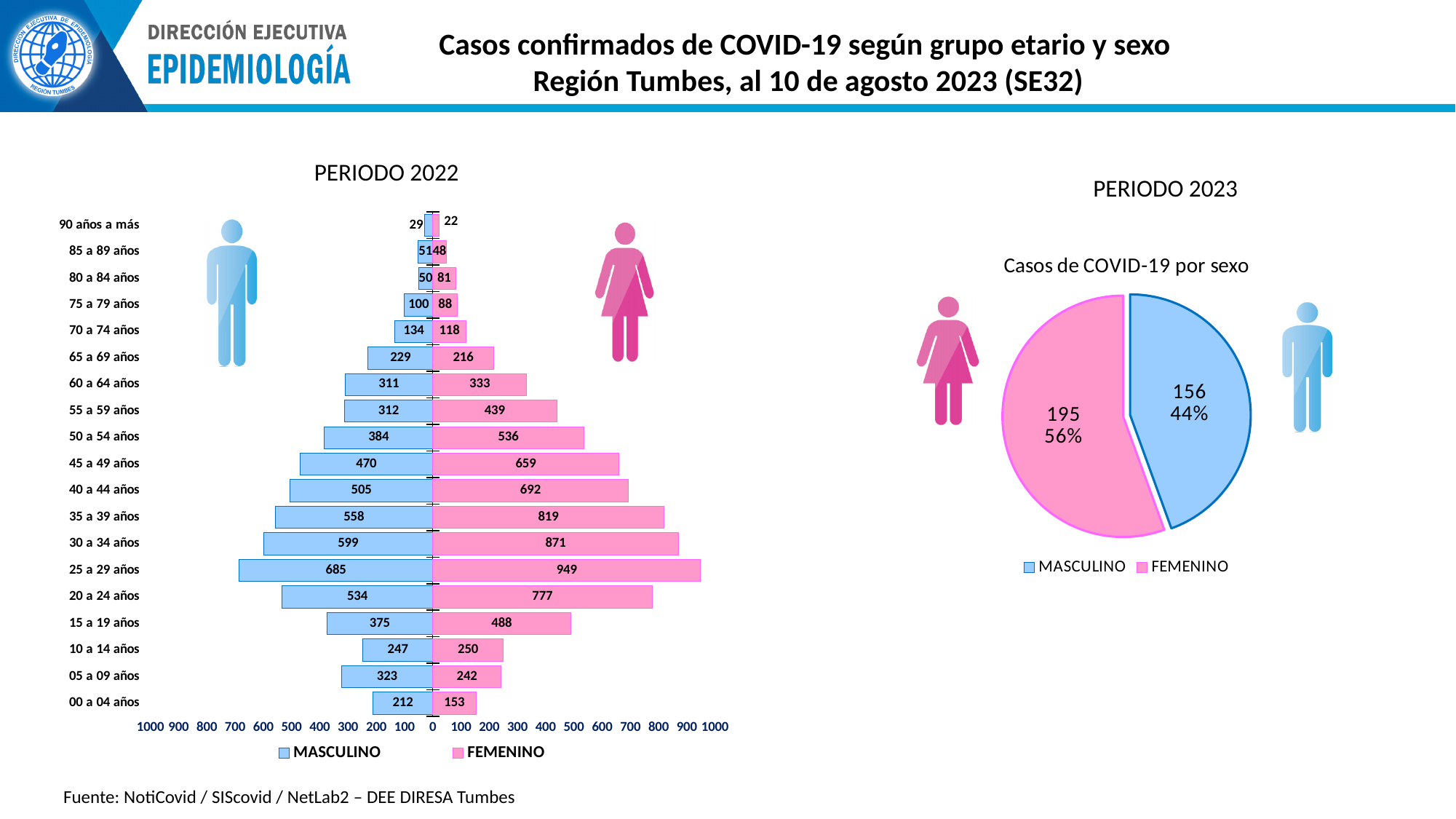
In the PERIODO 2022 chart, which age group has the highest FEMENINO value? 25 a 29 años In the PERIODO 2023 pie chart, how many cases are FEMENINO? 195 How many series does the legend of the PERIODO 2022 chart list? 2 How many age groups are shown in the PERIODO 2022 chart? 19 In the PERIODO 2023 pie chart, what share of cases is MASCULINO? 44% What is the title of the PERIODO 2023 pie chart? Casos de COVID-19 por sexo In the PERIODO 2022 chart, which age group has the lowest MASCULINO value? 90 años a más In the PERIODO 2022 chart, how many FEMENINO cases are shown for the 30 a 34 años group? 871 What kind of chart is the PERIODO 2022 chart? Bar chart In the PERIODO 2022 chart, which is larger for the 05 a 09 años group, MASCULINO or FEMENINO? MASCULINO In the PERIODO 2022 chart, how many MASCULINO cases are shown for the 25 a 29 años group? 685 In the PERIODO 2022 chart, what is the difference between the FEMENINO and MASCULINO values for the 35 a 39 años group? 261